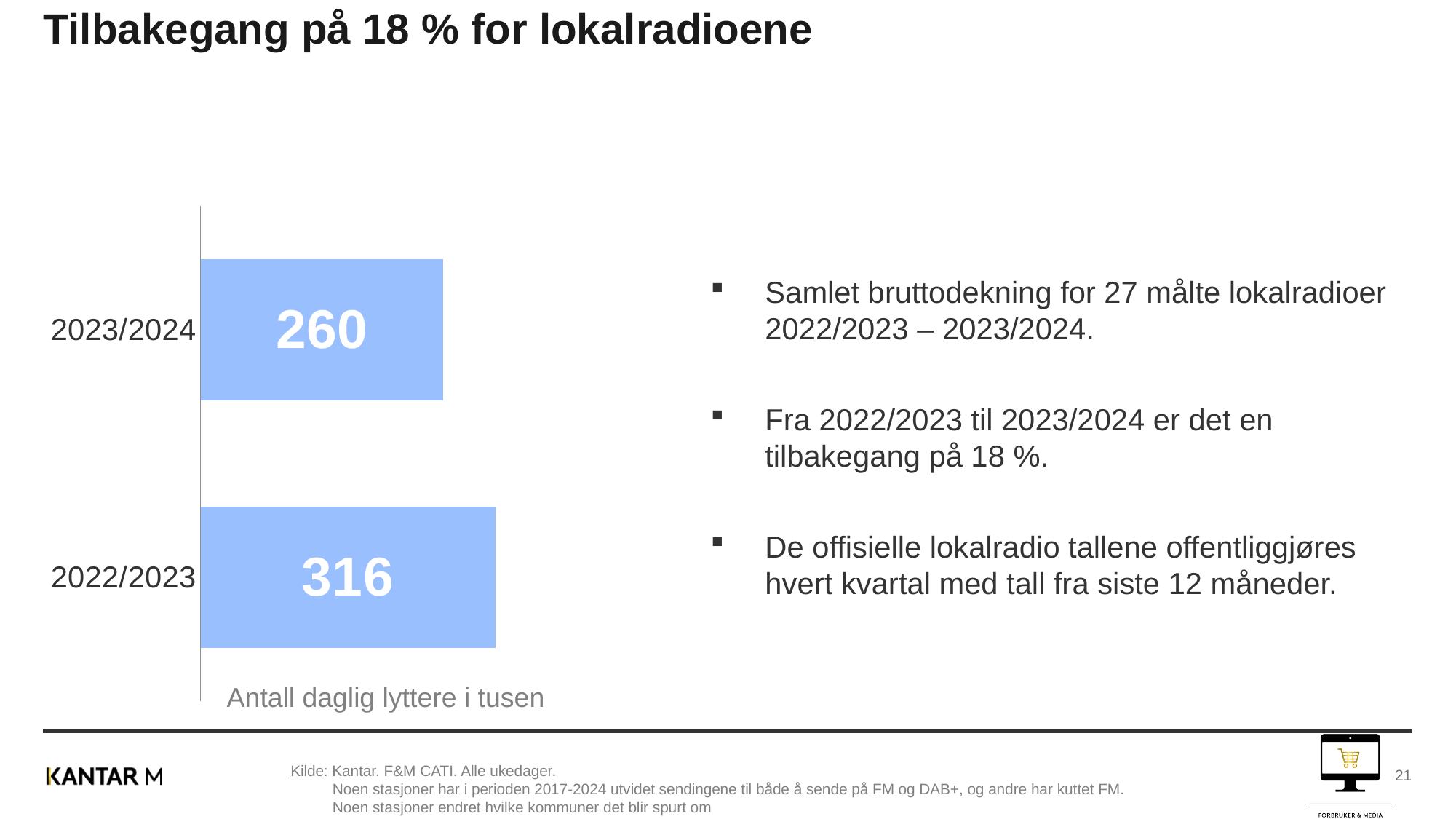
Which period has the lower value? 2023/2024 What is the difference between the 2022/2023 and 2023/2024 values? 56 What unit label is shown below the chart? Antall daglig lyttere i tusen Did the number of daily listeners rise or fall from 2022/2023 to 2023/2024? fall What is the value for 2022/2023? 316 What kind of chart is shown on the slide? bar chart Which period has the higher value? 2022/2023 How many bars does the chart show? 2 What colour are the bars in the chart? light blue What is the value for 2023/2024? 260 Is the value for 2022/2023 larger or smaller than the value for 2023/2024? larger